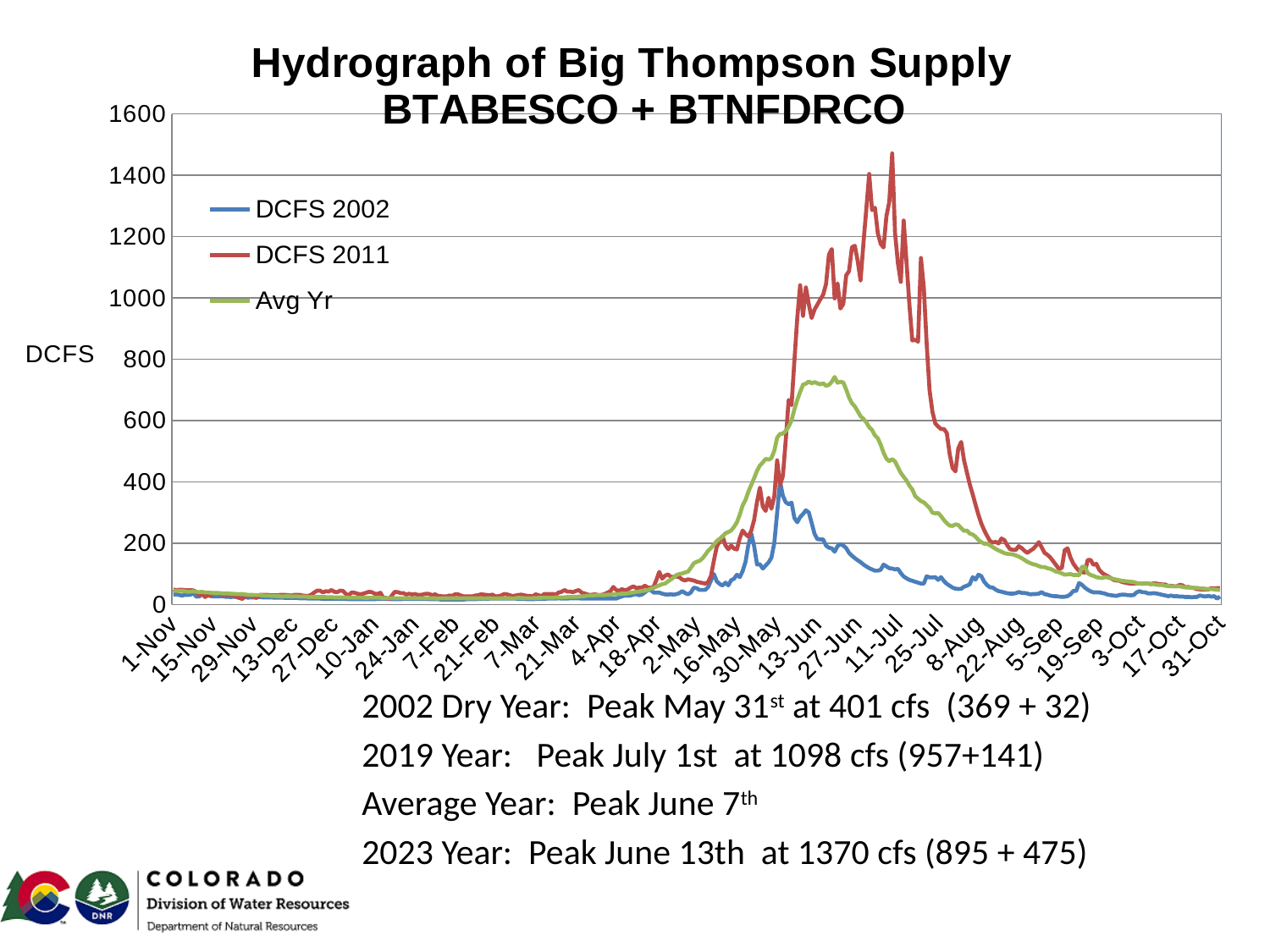
Is the peak value of the Avg Yr series greater or less than 800? less Around 27-Jun, which series is higher, DCFS 2011 or Avg Yr? DCFS 2011 Which series reaches the highest peak value on the chart? DCFS 2011 From 13-Jun to 31-Oct, does the Avg Yr series generally rise or fall? fall What kind of chart is shown on the slide? line chart Is the value for DCFS 2002 on 1-Nov greater or less than 200? less How many series does the chart's legend list? 3 What is the title of the chart? Hydrograph of Big Thompson Supply BTABESCO + BTNFDRCO Is the peak value of the DCFS 2011 series greater or less than 1400? greater Which series has the lowest peak value on the chart? DCFS 2002 What are the three series named in the chart's legend? DCFS 2002, DCFS 2011, Avg Yr